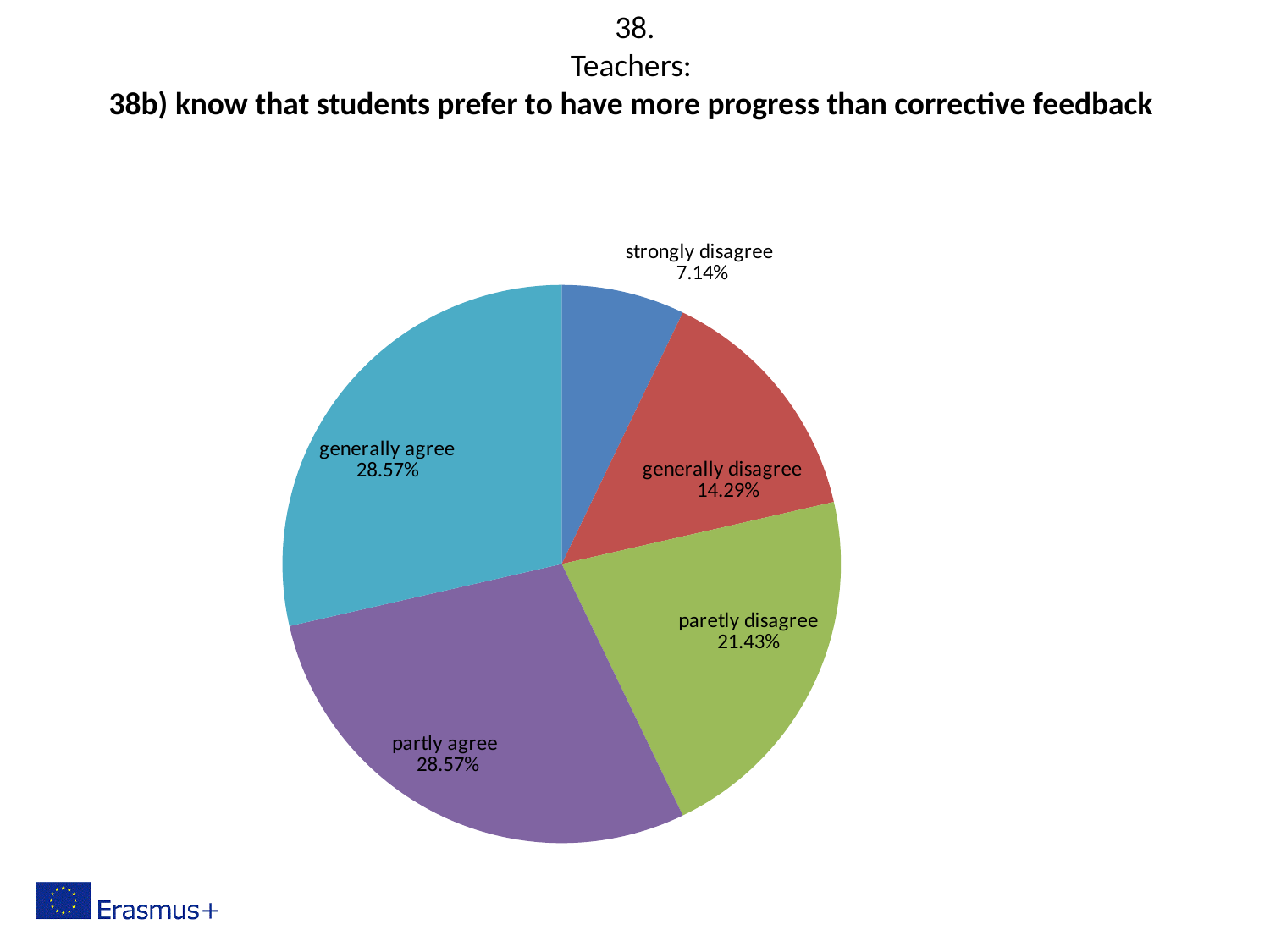
What is the difference in percentage points between the "paretly disagree" slice and the "generally disagree" slice? 7.14 What share of the pie is labelled "generally agree"? 28.57% What colour is the "partly agree" slice of the pie? purple Which slice of the pie is the smallest? strongly disagree What share of the pie is labelled "generally disagree"? 14.29% Which is larger, the "generally disagree" slice or the "paretly disagree" slice? paretly disagree What share of the pie is labelled "partly agree"? 28.57% What kind of chart is shown on the slide? pie chart How many slices does the pie chart have? 5 What is the difference in percentage points between the "partly agree" slice and the "strongly disagree" slice? 21.43